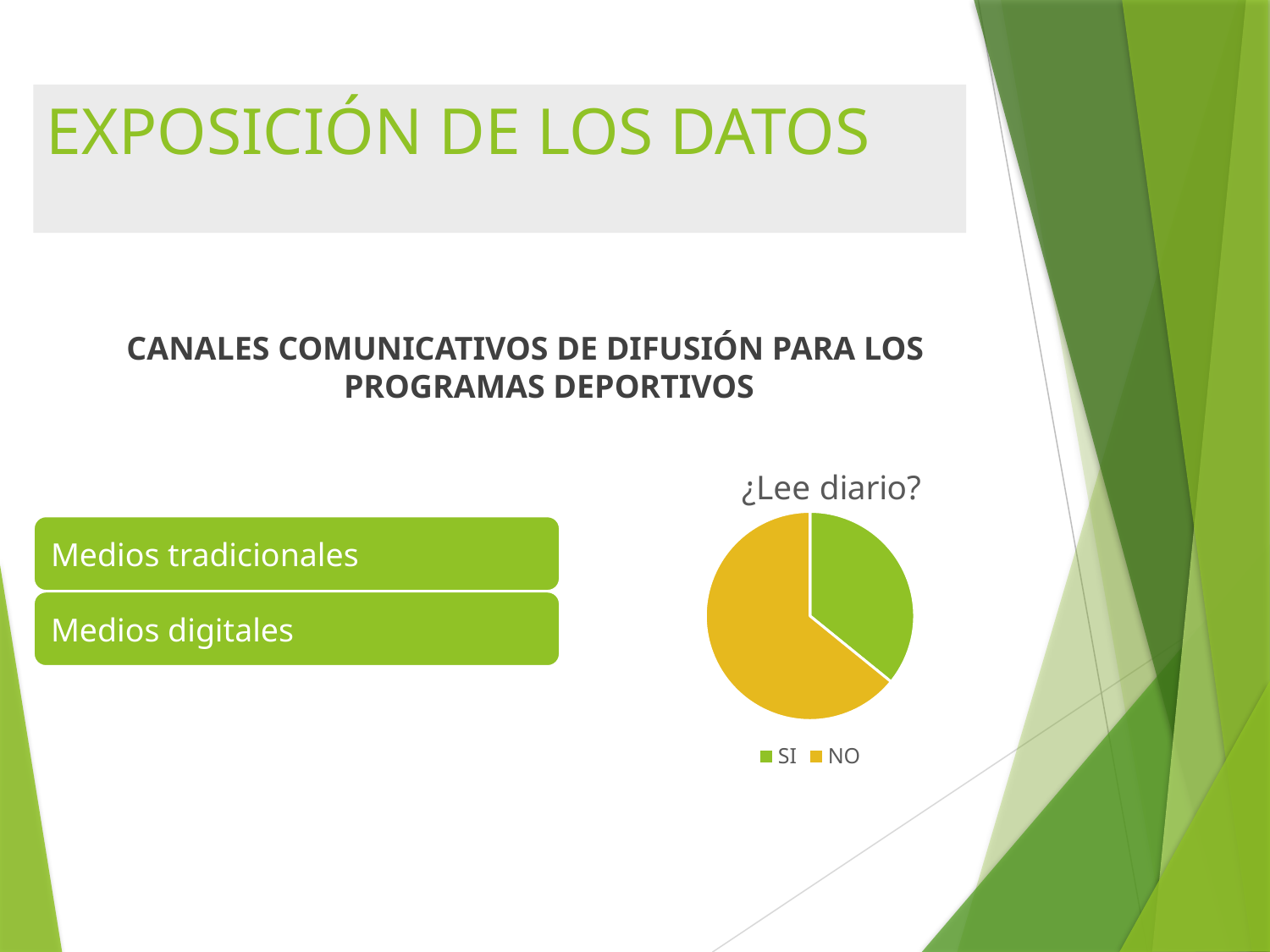
What is the title of the pie chart? ¿Lee diario? How many slices does the pie chart have? 2 What kind of chart is shown on the slide? pie chart What colour is the SI slice in the pie chart? green What are the two categories listed in the legend of the pie chart? SI and NO How many entries does the legend of the pie chart list? 2 Which slice is larger in the pie chart, SI or NO? NO Which category has the smallest slice in the pie chart? SI Which category has the largest slice in the pie chart? NO